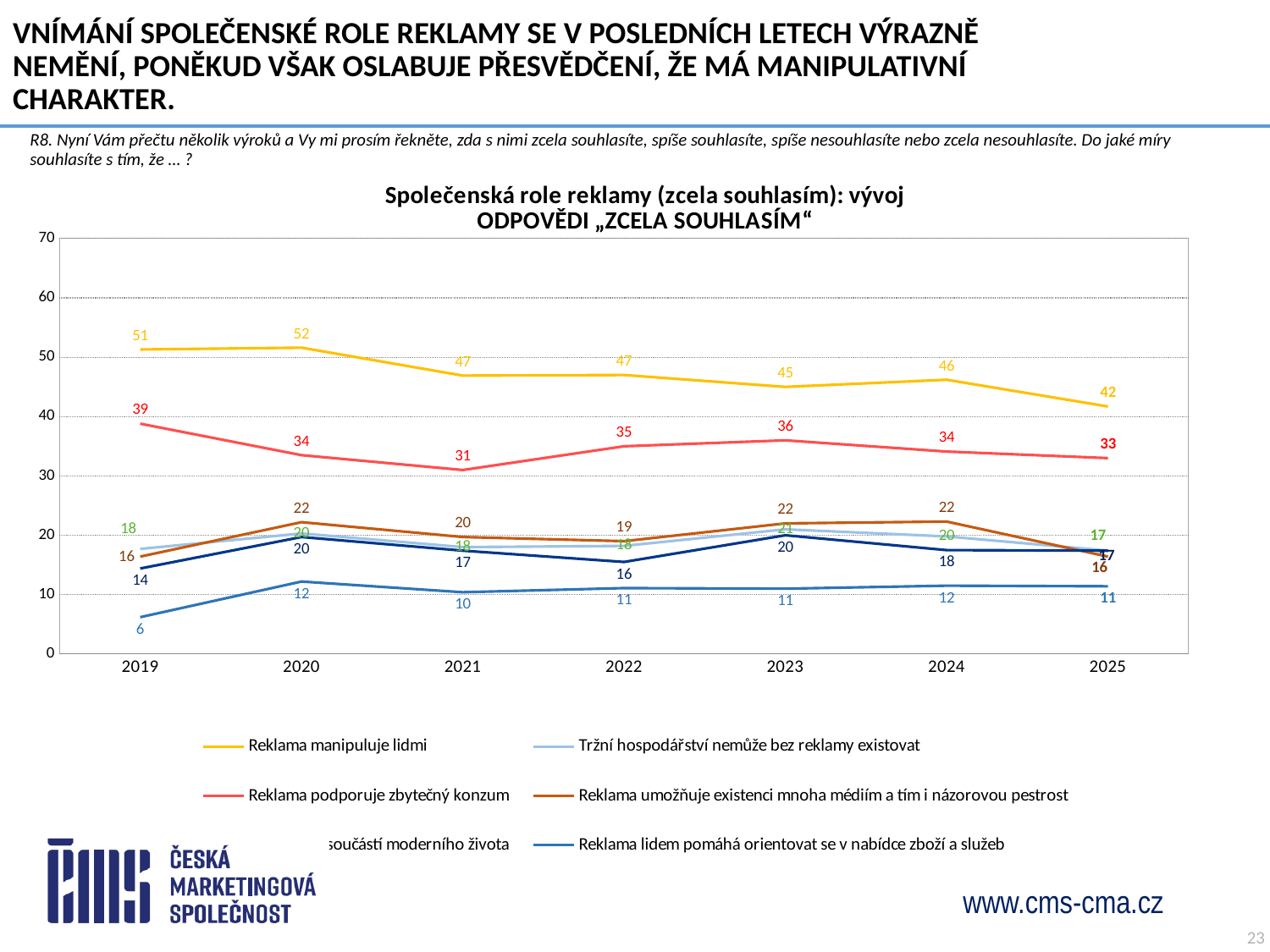
In which year does 'Reklama podporuje zbytečný konzum' reach its lowest value? 2021 How many years are shown on the x axis of the chart? 7 Does the value for 'Reklama manipuluje lidmi' rise or fall overall from 2019 to 2025? Fall How many series does the chart legend list? 6 What type of chart is shown on the slide? Line chart What value does the line 'Reklama lidem pomáhá orientovat se v nabídce zboží a služeb' show for 2019? 6 In which year does 'Reklama manipuluje lidmi' reach its highest value? 2020 What value does the line 'Reklama manipuluje lidmi' show for 2019? 51 What value does the line 'Reklama podporuje zbytečný konzum' show for 2025? 33 By how much did the value for 'Reklama manipuluje lidmi' fall between 2020 and 2025? 10 What value does the line 'Reklama umožňuje existenci mnoha médiím a tím i názorovou pestrost' show for 2020? 22 In 2023, which is higher: 'Reklama podporuje zbytečný konzum' or 'Reklama umožňuje existenci mnoha médiím a tím i názorovou pestrost'? Reklama podporuje zbytečný konzum